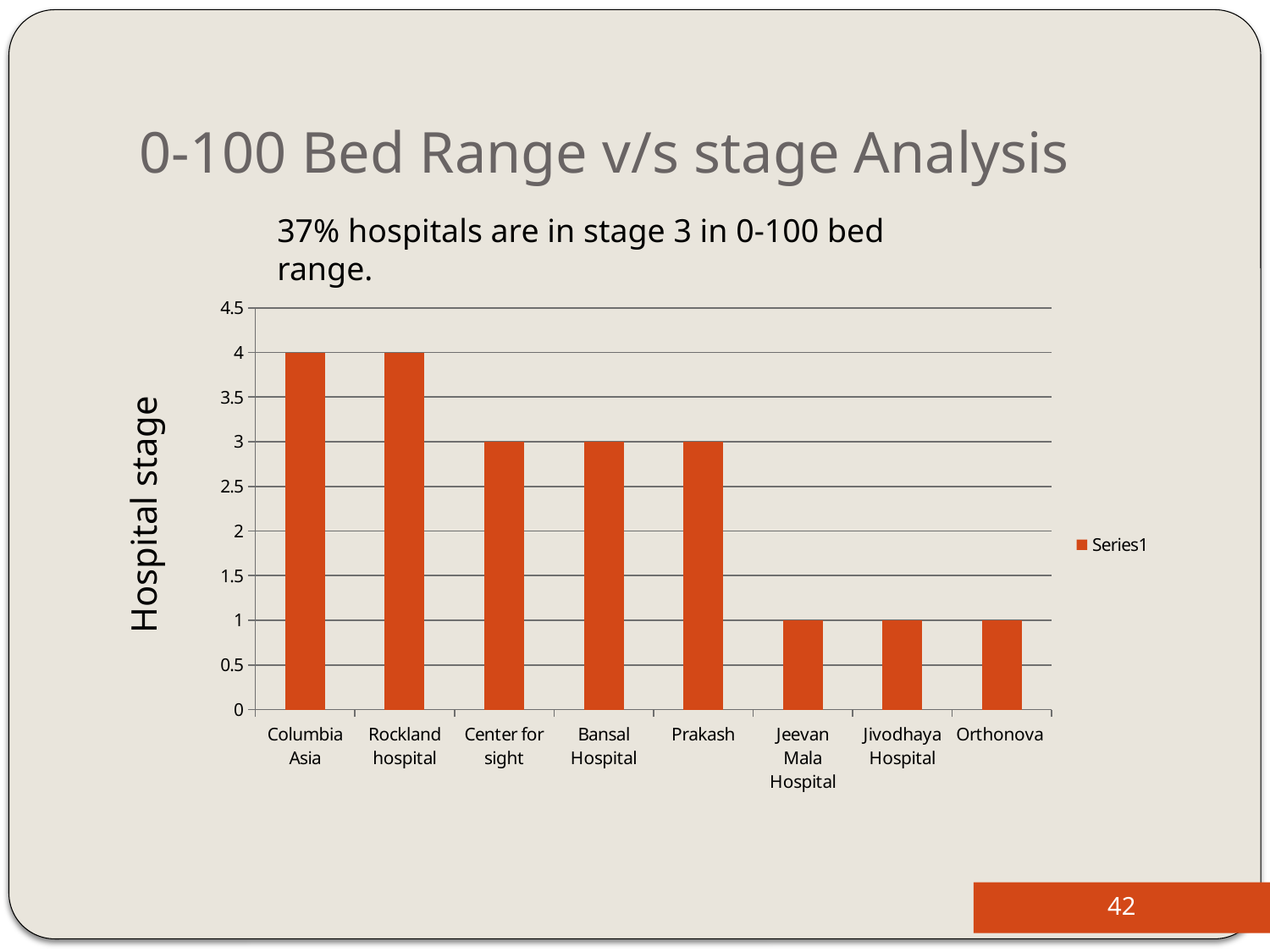
Which hospital has the lowest stage among Columbia Asia, Center for sight and Jivodhaya Hospital? Jivodhaya Hospital What kind of chart is shown on the slide? bar chart How many hospitals are shown on the x axis of the chart? 8 What is the difference in hospital stage between Rockland hospital and Bansal Hospital? 1 Which has a higher hospital stage, Center for sight or Jeevan Mala Hospital? Center for sight What is the hospital stage for Jeevan Mala Hospital? 1 Is the value for Bansal Hospital greater or less than 2? greater What is the hospital stage for Orthonova? 1 What is the hospital stage for Columbia Asia? 4 What is the label of the y axis of the chart? Hospital stage What is the hospital stage for Prakash? 3 What is the difference in hospital stage between Columbia Asia and Orthonova? 3